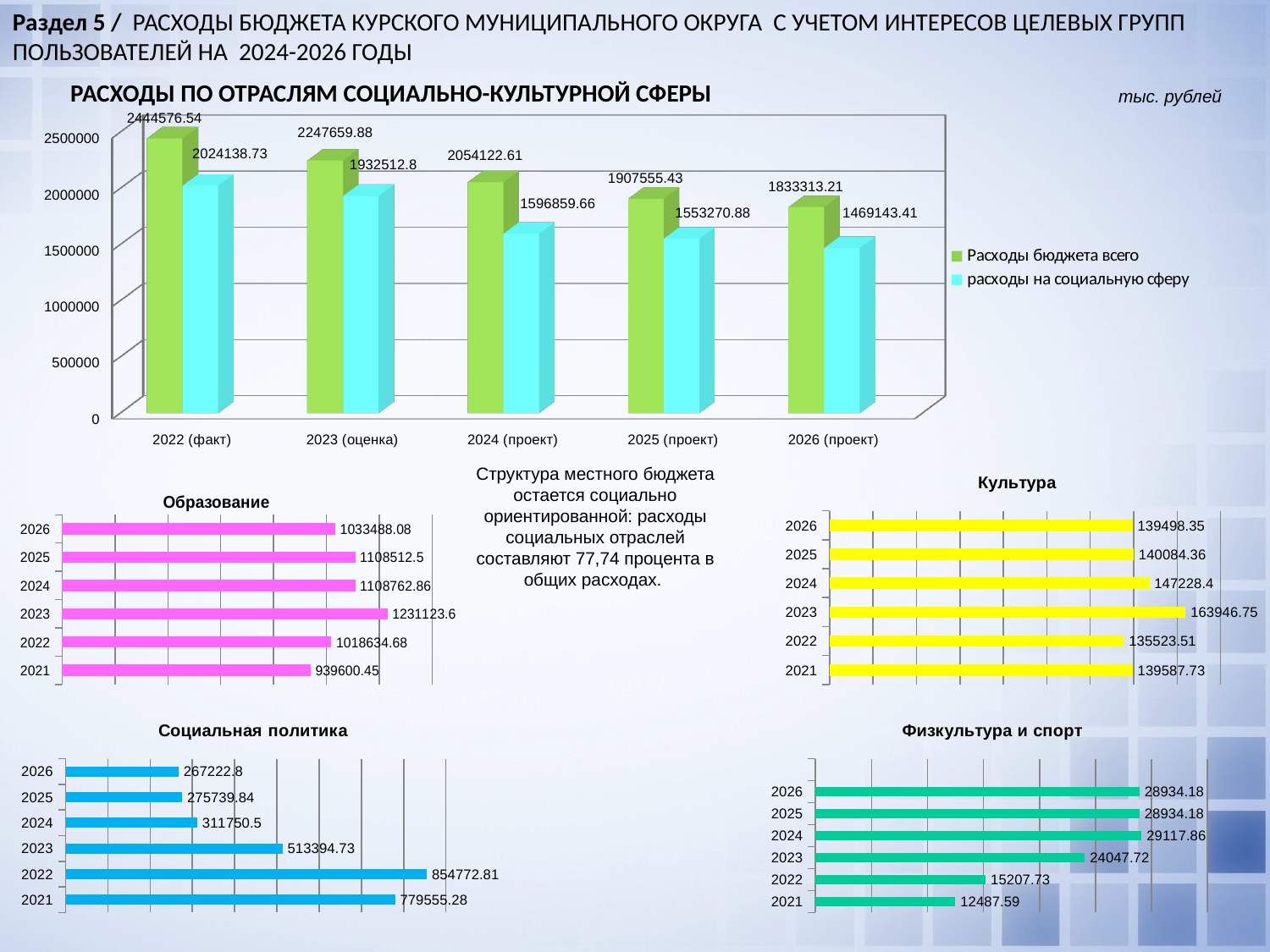
On the chart 'РАСХОДЫ ПО ОТРАСЛЯМ СОЦИАЛЬНО-КУЛЬТУРНОЙ СФЕРЫ', how many series does the legend list? 2 On the 'Социальная политика' chart, what is the value for 2022? 854772.81 On the 'Физкультура и спорт' chart, how many years are shown? 6 On the 'Социальная политика' chart, what is the difference between the values for 2022 and 2021? 75217.53 On the chart 'РАСХОДЫ ПО ОТРАСЛЯМ СОЦИАЛЬНО-КУЛЬТУРНОЙ СФЕРЫ', do the values of 'Расходы бюджета всего' rise or fall from 2022 to 2026? fall On the chart 'РАСХОДЫ ПО ОТРАСЛЯМ СОЦИАЛЬНО-КУЛЬТУРНОЙ СФЕРЫ', what is the value of 'расходы на социальную сферу' for 2026 (проект)? 1469143.41 What kind of chart is 'РАСХОДЫ ПО ОТРАСЛЯМ СОЦИАЛЬНО-КУЛЬТУРНОЙ СФЕРЫ'? bar chart On the 'Культура' chart, which year has the lowest value? 2022 On the 'Образование' chart, what is the value for 2021? 939600.45 On the 'Физкультура и спорт' chart, which year has the lowest value? 2021 On the chart 'РАСХОДЫ ПО ОТРАСЛЯМ СОЦИАЛЬНО-КУЛЬТУРНОЙ СФЕРЫ', what is the value of 'Расходы бюджета всего' for 2022 (факт)? 2444576.54 On the 'Образование' chart, which year has the highest value? 2023